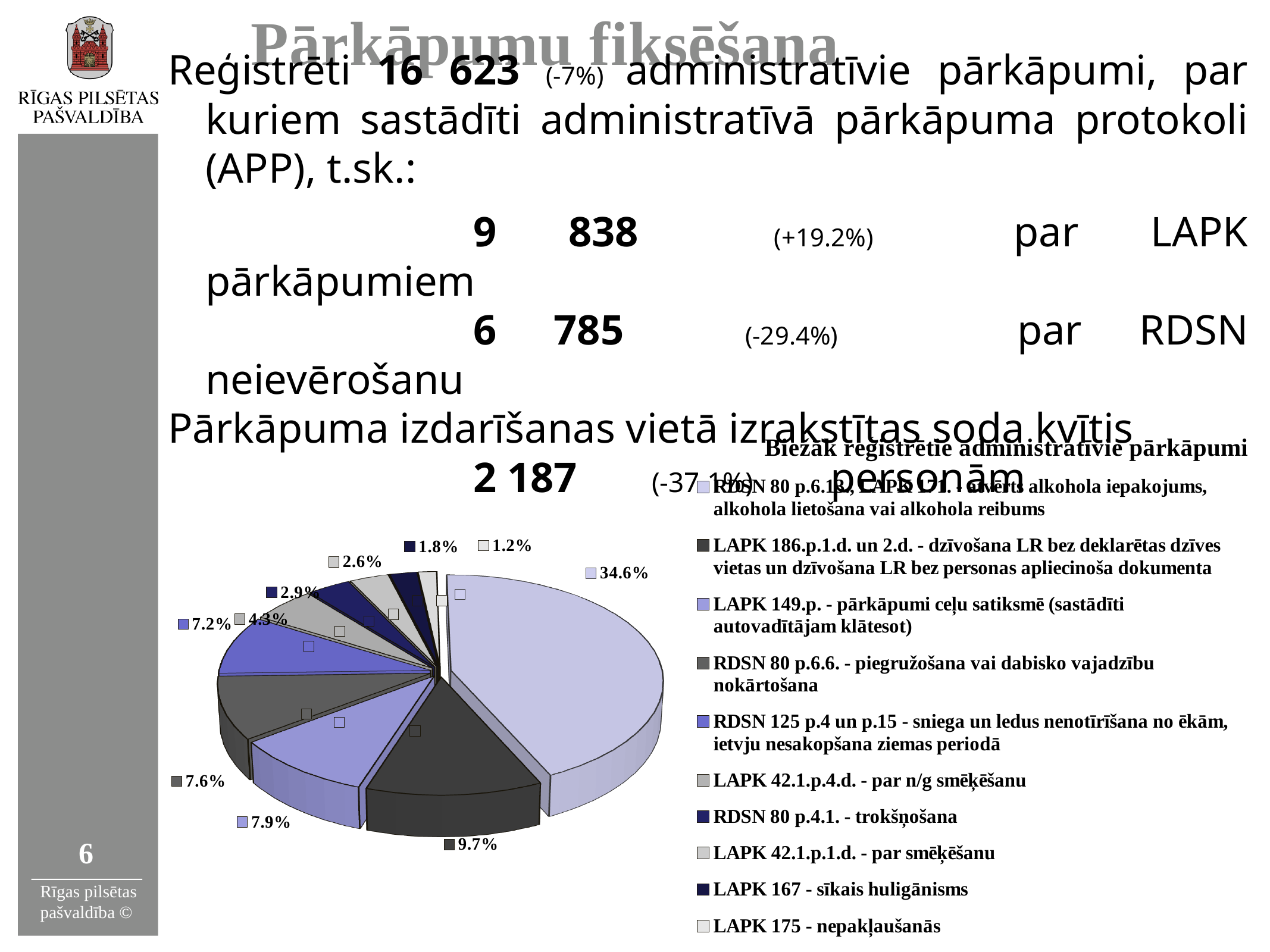
What share of the pie is labelled for the largest slice? 34.6% What is the title of the pie chart? Biežāk reģistrētie administratīvie pārkāpumi What is the difference between the largest slice (34.6%) and the second largest slice (9.7%)? 24.9% What kind of chart is shown on the slide? pie chart What percentage is shown for LAPK 186.p.1.d. un 2.d. (dzīvošana LR bez deklarētas dzīves vietas)? 9.7% Which legend category corresponds to the smallest slice (1.2%)? LAPK 175 - nepakļaušanās What percentage is shown for LAPK 149.p. - pārkāpumi ceļu satiksmē? 7.9% Which is larger: the slice labelled 7.6% or the slice labelled 7.2%? 7.6% How many entries does the legend of the pie chart list? 10 Which legend category has the largest slice in the pie chart? RDSN 80 p.6.13., LAPK 171. - atvērts alkohola iepakojums, alkohola lietošana vai alkohola reibums What is the smallest percentage labelled on the pie chart? 1.2% How many slices does the pie chart have? 10